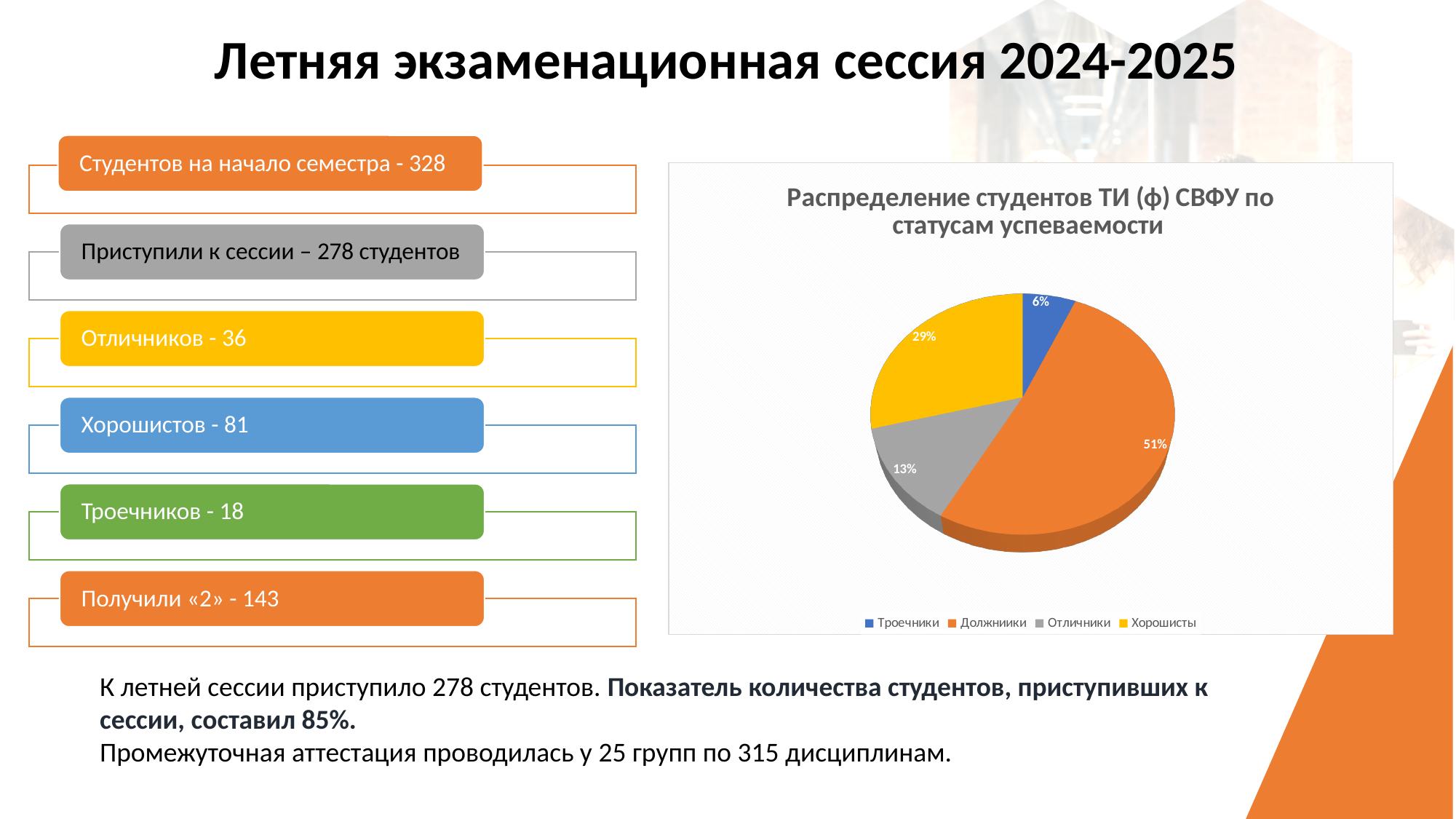
What colour is the Хорошисты slice in the pie chart? Yellow What share of the pie chart does the Отличники slice take? 13% What kind of chart is shown on the slide? Pie chart Which slice is larger, Отличники or Хорошисты? Хорошисты What share of the pie chart does the Должниики slice take? 51% What is the difference in percentage points between the Должниики and Хорошисты slices? 22 Which category has the largest slice in the pie chart? Должниики What share of the pie chart does the Троечники slice take? 6% Which category has the smallest slice in the pie chart? Троечники What is the title of the pie chart? Распределение студентов ТИ (ф) СВФУ по статусам успеваемости How many categories does the pie chart show? 4